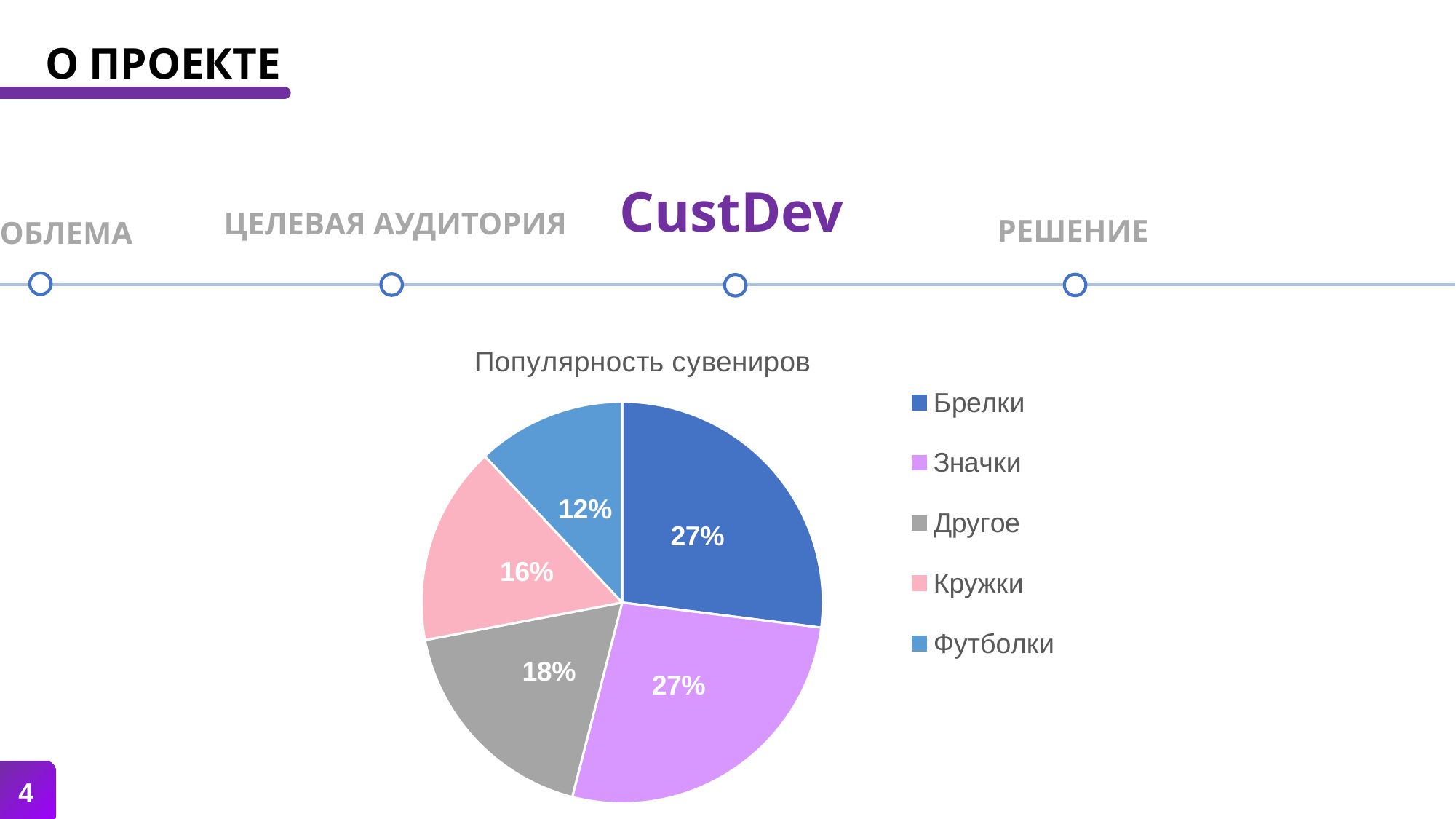
What type of chart is shown on the slide? Pie chart Which is larger, the slice for Кружки or the slice for Футболки? Кружки What share of the pie does Кружки have? 16% What share of the pie does Значки have? 27% Which category has the smallest slice of the pie? Футболки What is the difference in percentage points between Другое and Футболки? 6 What share of the pie does Брелки have? 27% What is the title of the chart? Популярность сувениров What share of the pie does Другое have? 18% How many categories does the pie chart have? 5 What colour is the slice for Кружки? Pink What share of the pie does Футболки have? 12%